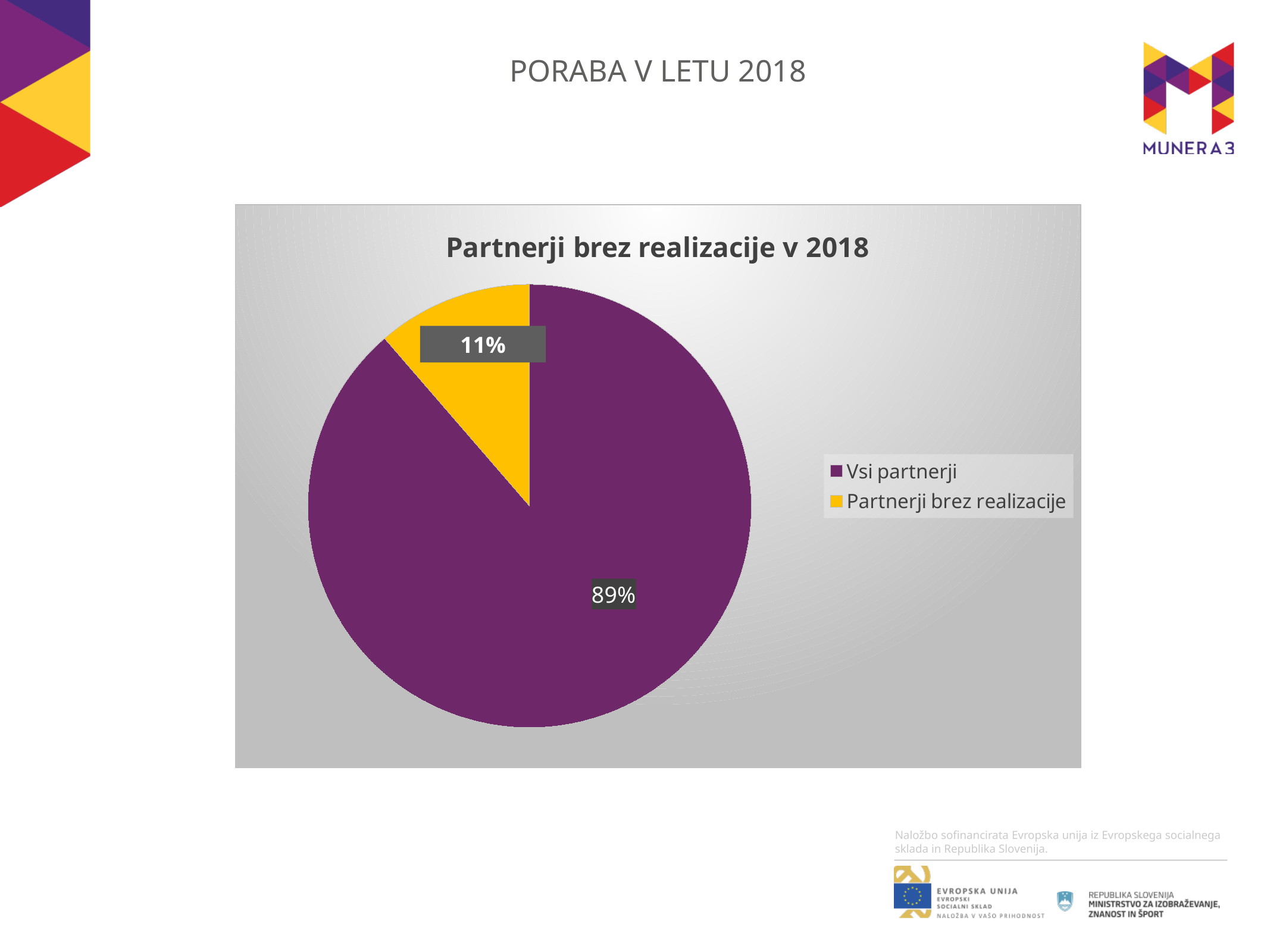
How many entries does the legend list? 2 What share of the pie does "Vsi partnerji" take? 89% What is the difference in percentage points between the "Vsi partnerji" slice and the "Partnerji brez realizacije" slice? 78 Which is larger, the "Vsi partnerji" slice or the "Partnerji brez realizacije" slice? Vsi partnerji How many slices does the pie chart have? 2 Which slice is the smallest? Partnerji brez realizacije What colour is the "Partnerji brez realizacije" slice? yellow Which slice is the largest? Vsi partnerji What is the title of the chart? Partnerji brez realizacije v 2018 What kind of chart is shown on the slide? pie chart What share of the pie does "Partnerji brez realizacije" take? 11%